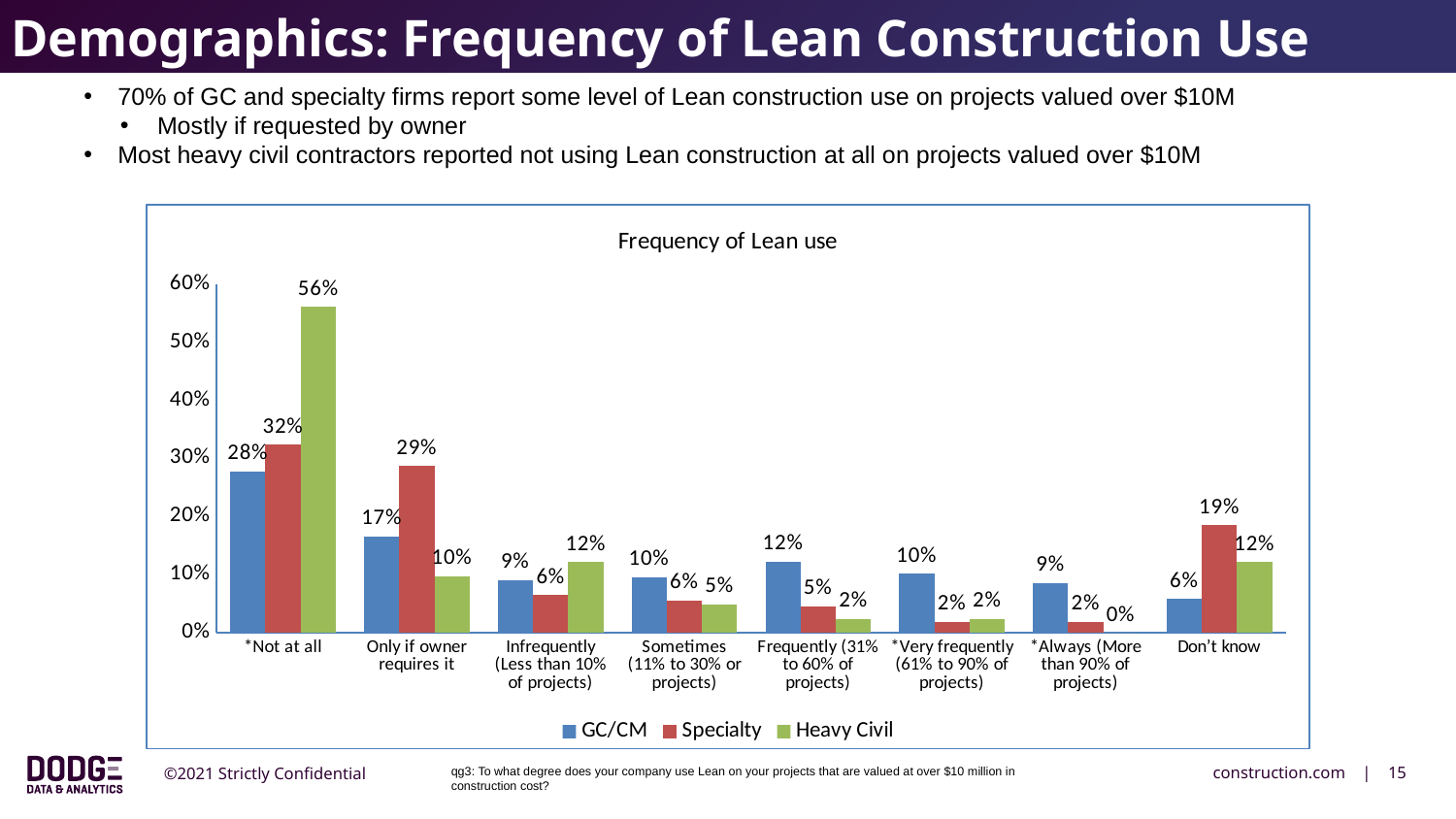
Is the Specialty value for "*Not at all" greater or less than 30%? greater What is the Heavy Civil value for "*Not at all"? 56% Which category has the highest Heavy Civil value? *Not at all How many series does the legend list? 3 Which category has the lowest Heavy Civil value? *Always (More than 90% of projects) What type of chart is shown? Bar chart What is the difference between the Heavy Civil and GC/CM values for "*Not at all"? 28% How many categories are shown on the x axis? 8 What is the Specialty value for "Don't know"? 19% What is the Specialty value for "Only if owner requires it"? 29% What is the GC/CM value for "Frequently (31% to 60% of projects)"? 12% For "Only if owner requires it", which series has the larger value, GC/CM or Specialty? Specialty